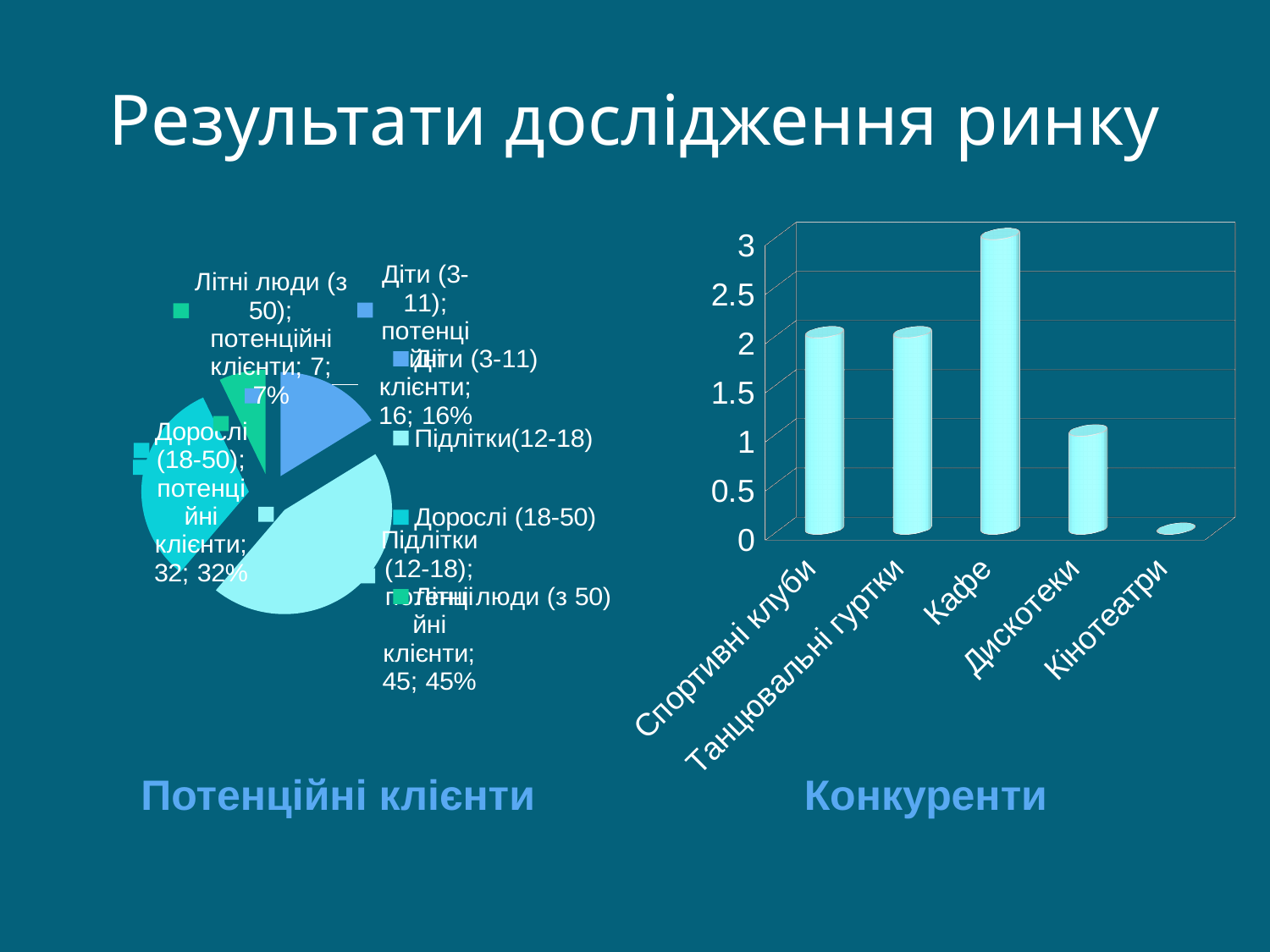
On the 'Потенційні клієнти' pie chart, which category has the largest slice? Підлітки (12-18) How many categories does the legend of the 'Потенційні клієнти' pie chart list? 4 On the 'Конкуренти' chart, which category has the lowest value? Кінотеатри On the 'Потенційні клієнти' pie chart, what is the value for Літні люди (з 50)? 7 On the 'Конкуренти' chart, what is the value for Дискотеки? 1 On the 'Потенційні клієнти' pie chart, what is the value for Дорослі (18-50)? 32 On the 'Потенційні клієнти' pie chart, what is the difference between the values for Підлітки (12-18) and Діти (3-11)? 29 On the 'Потенційні клієнти' pie chart, what share do Підлітки (12-18) have? 45% On the 'Конкуренти' chart, which category has the highest value? Кафе What kind of chart is the 'Конкуренти' chart? Bar chart On the 'Потенційні клієнти' pie chart, which category has the smallest slice? Літні люди (з 50) On the 'Конкуренти' chart, how many categories are shown on the x axis? 5